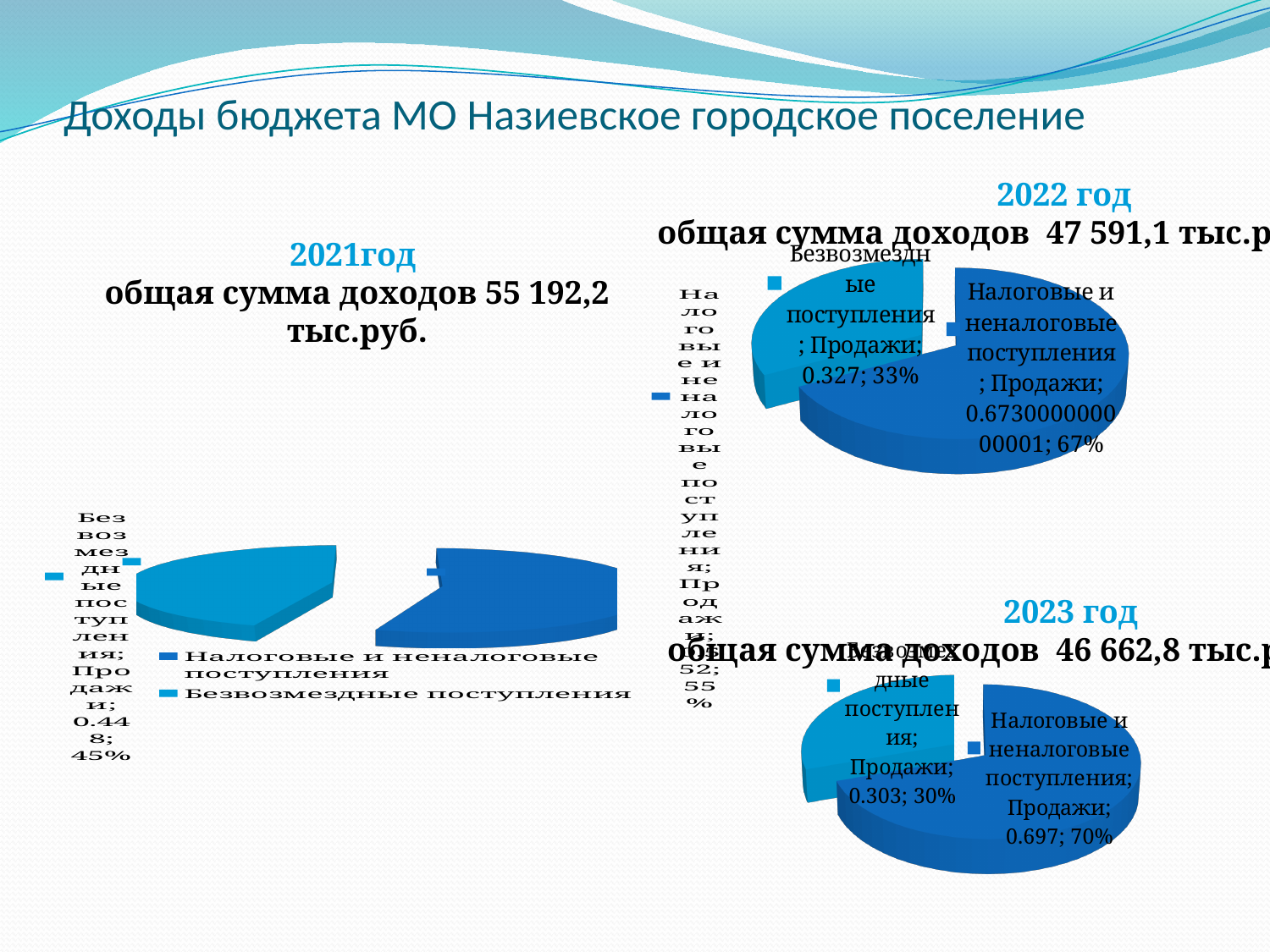
In the 2023 chart, what share of the pie is Безвозмездные поступления? 30% In the 2023 chart, which slice is the largest? Налоговые и неналоговые поступления What kind of chart is the 2022 chart? Pie chart In the 2021 chart, which is larger: Налоговые и неналоговые поступления or Безвозмездные поступления? Налоговые и неналоговые поступления What total income is stated above the 2022 chart? 47 591,1 тыс.руб. In the 2022 chart, which slice is the smallest? Безвозмездные поступления How many slices does the 2023 chart have? 2 In the 2022 chart, what share of the pie is Налоговые и неналоговые поступления? 67% In the 2021 chart, what share of the pie is Налоговые и неналоговые поступления? 55% In the 2023 chart, what value is printed for Налоговые и неналоговые поступления? 0.697